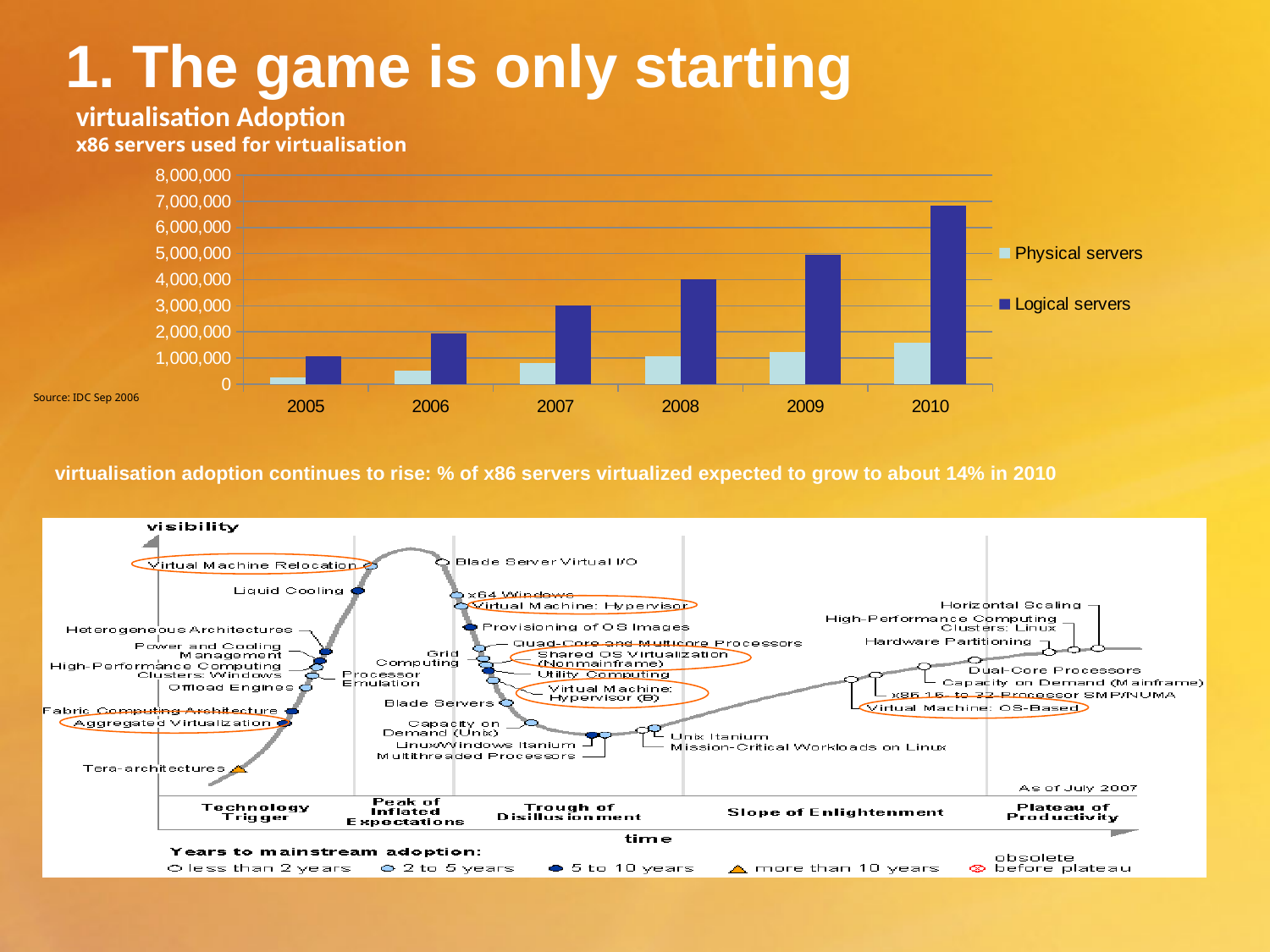
In the 'x86 servers used for virtualisation' chart, is the value for Logical servers in 2010 greater or less than 6,000,000? greater In the 'x86 servers used for virtualisation' chart, what are the two legend entries? Physical servers, Logical servers In the 'x86 servers used for virtualisation' chart, do the Logical servers values rise or fall from 2005 to 2010? rise In the 'x86 servers used for virtualisation' chart, is the value for Logical servers in 2009 greater or less than 4,000,000? greater In the 'x86 servers used for virtualisation' chart, which year has the lowest value for Physical servers? 2005 In the 'x86 servers used for virtualisation' chart, how many years are shown on the x axis? 6 In the 'x86 servers used for virtualisation' chart, which is larger in 2010: Physical servers or Logical servers? Logical servers In the 'x86 servers used for virtualisation' chart, is the value for Physical servers in 2010 greater or less than 2,000,000? less In the 'x86 servers used for virtualisation' chart, what kind of chart is used? bar chart In the 'x86 servers used for virtualisation' chart, how many series does the legend list? 2 What source is cited for the 'x86 servers used for virtualisation' chart? IDC Sep 2006 In the 'x86 servers used for virtualisation' chart, which year has the highest value for Logical servers? 2010